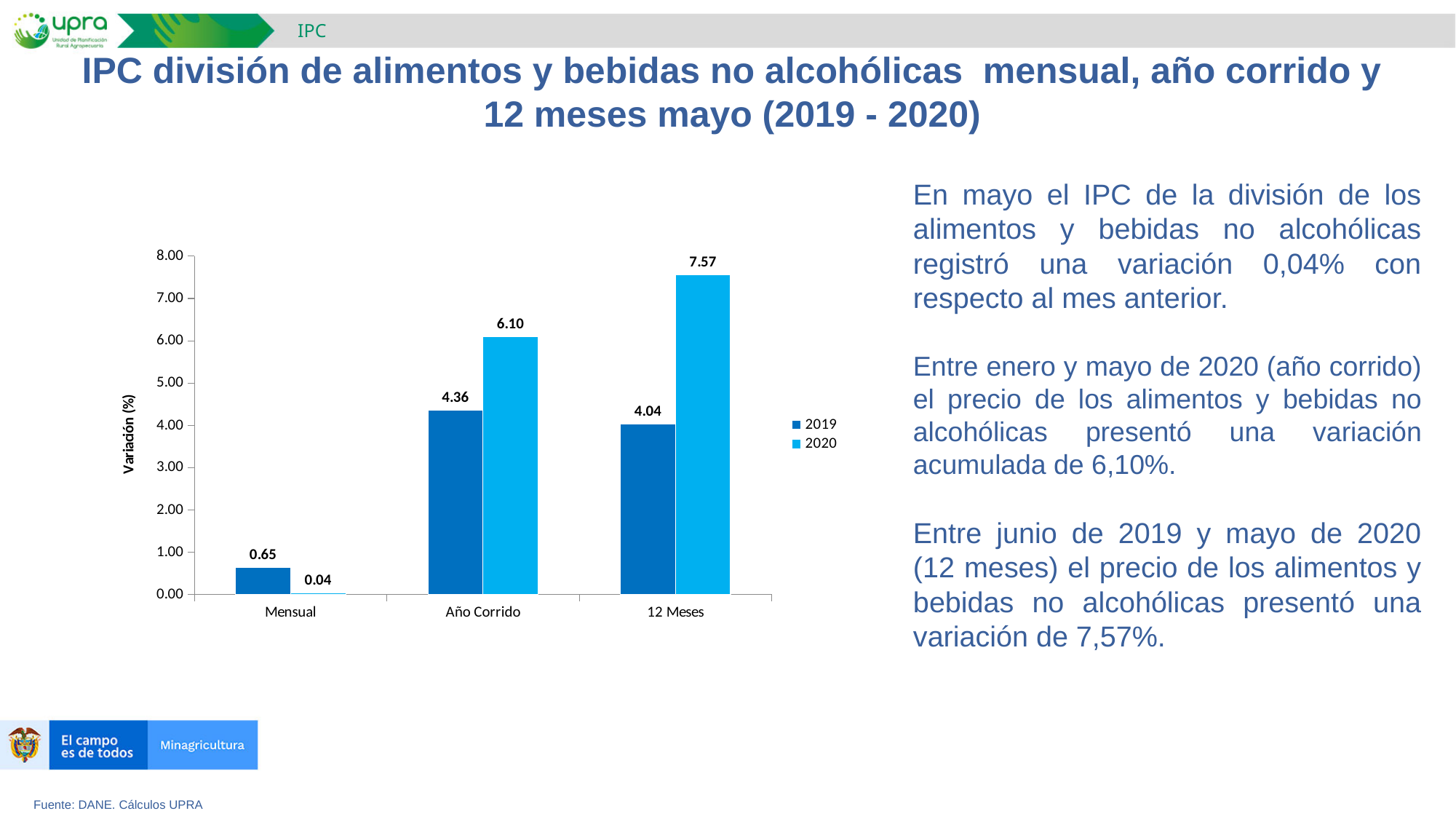
How many categories are shown on the x axis? 3 What is the difference between the 2020 and 2019 values in the 12 Meses category? 3.53 Which is larger in the Año Corrido category, the 2019 value or the 2020 value? 2020 What is the value for 2019 in the Mensual category? 0.65 How many series does the legend list? 2 Which category has the lowest value for the 2019 series? Mensual Which category has the highest value for the 2020 series? 12 Meses What kind of chart is shown on the slide? Bar chart What is the value for 2020 in the 12 Meses category? 7.57 What is the value for 2020 in the Año Corrido category? 6.10 What is the value for 2019 in the 12 Meses category? 4.04 What is the label of the vertical axis? Variación (%)